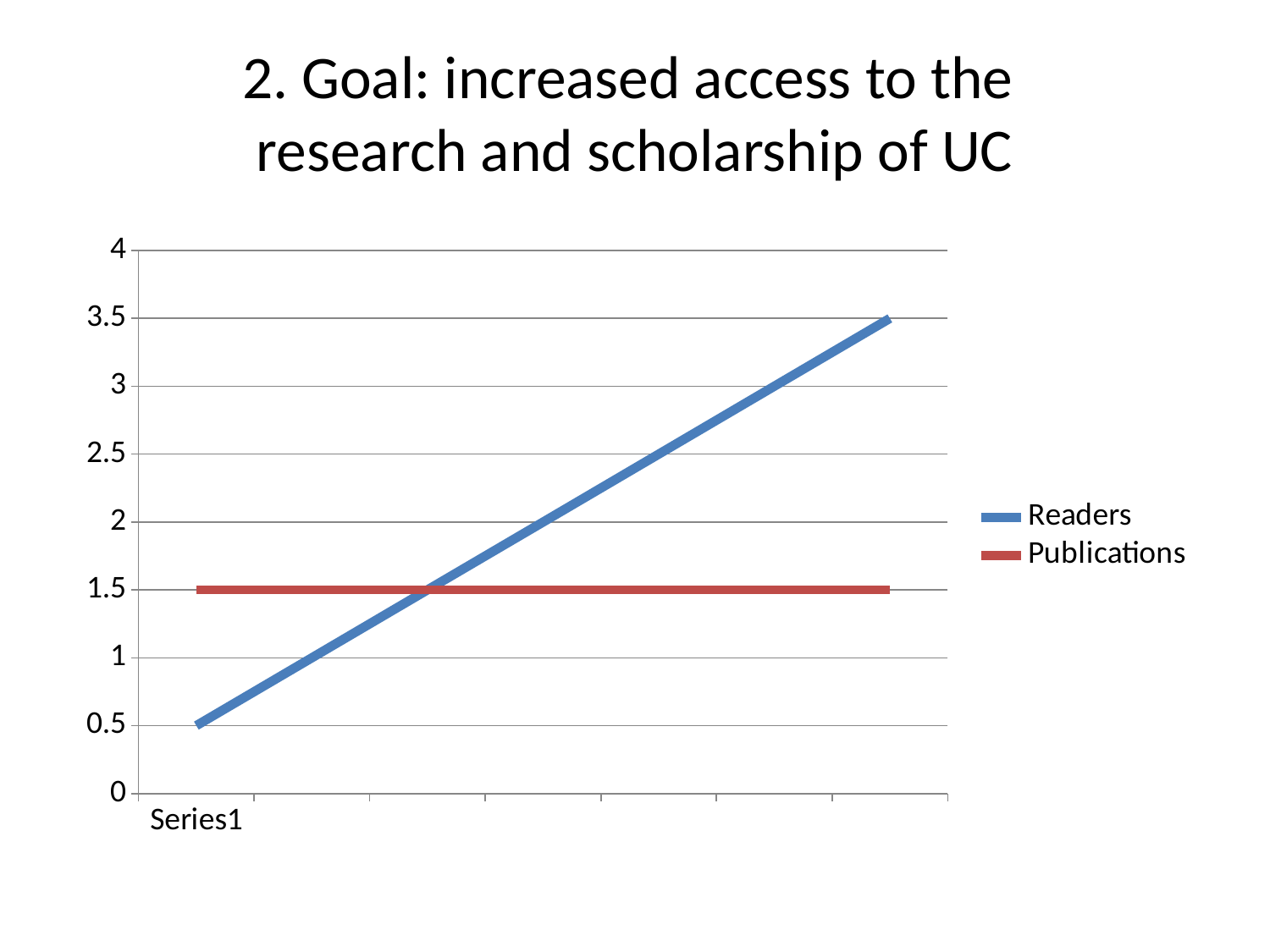
What is the value of Readers at the last point on the right? 3.5 What constant value does the Publications line sit at? 1.5 What kind of chart is shown on the slide? line chart Does the Readers line rise or fall from left to right? rise What colour is the Readers line? blue How many series does the legend list? 2 Does the Publications line rise, fall, or stay flat across the chart? stay flat At the last point on the right, which is larger, Readers or Publications? Readers At the first point (Series1), which is larger, Readers or Publications? Publications By how much does the Readers line increase from its first point to its last point? 3 What are the two series named in the legend? Readers and Publications What is the value of Readers at the first point (Series1)? 0.5